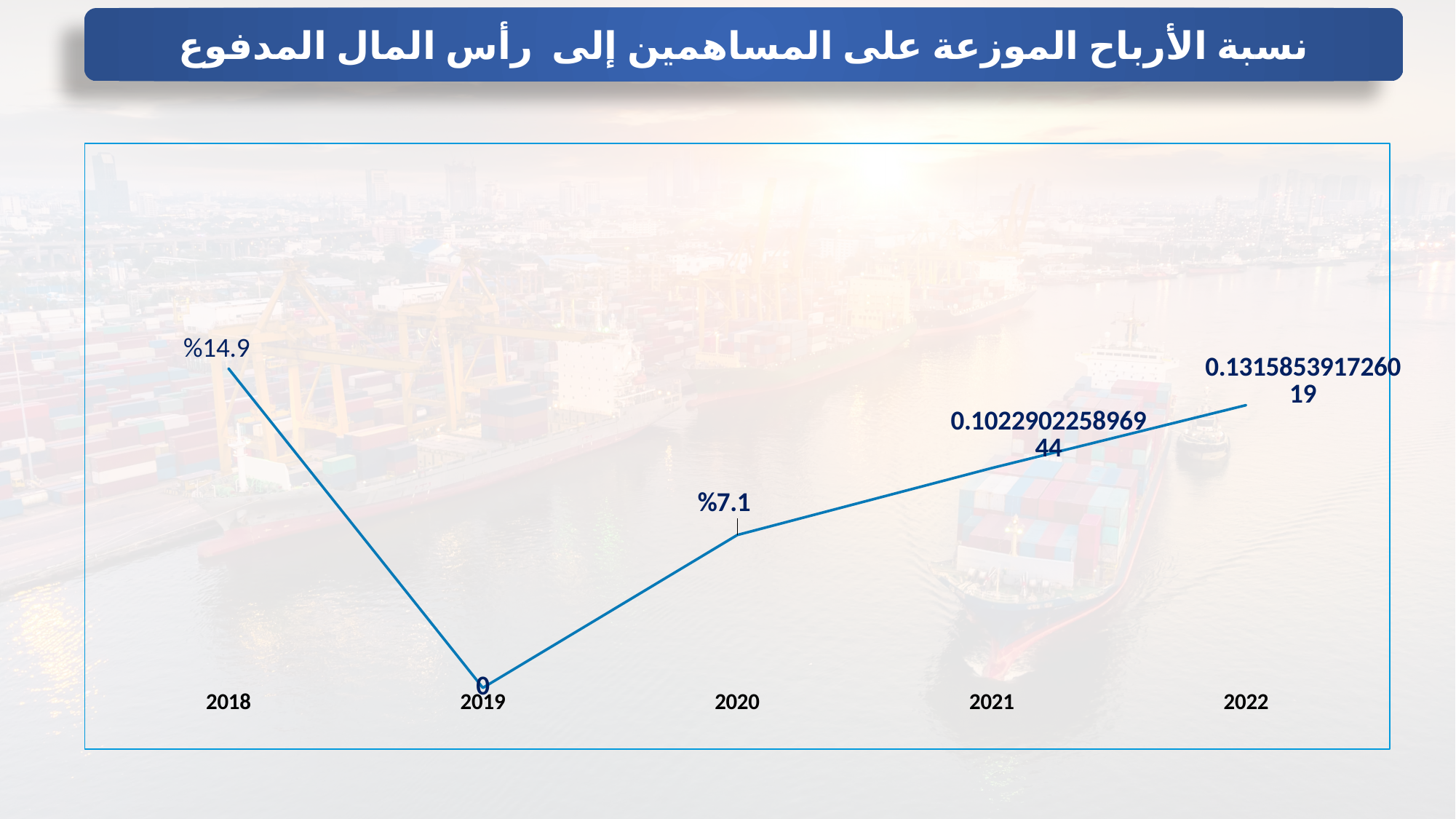
What type of chart is shown on the slide? Line chart How many years are plotted on the chart? 5 What is the data label shown for 2021? 0.102290225896944 What is the value shown for 2018? %14.9 Do the values rise or fall from 2019 to 2022? Rise What is the value shown for 2019? 0 Which year has the larger value, 2020 or 2021? 2021 What is the value shown for 2020? %7.1 Which year has the highest value on the chart? 2018 What is the data label shown for 2022? 0.131585391726019 What is the difference between the values for 2018 and 2020? %7.8 Which year has the lowest value on the chart? 2019